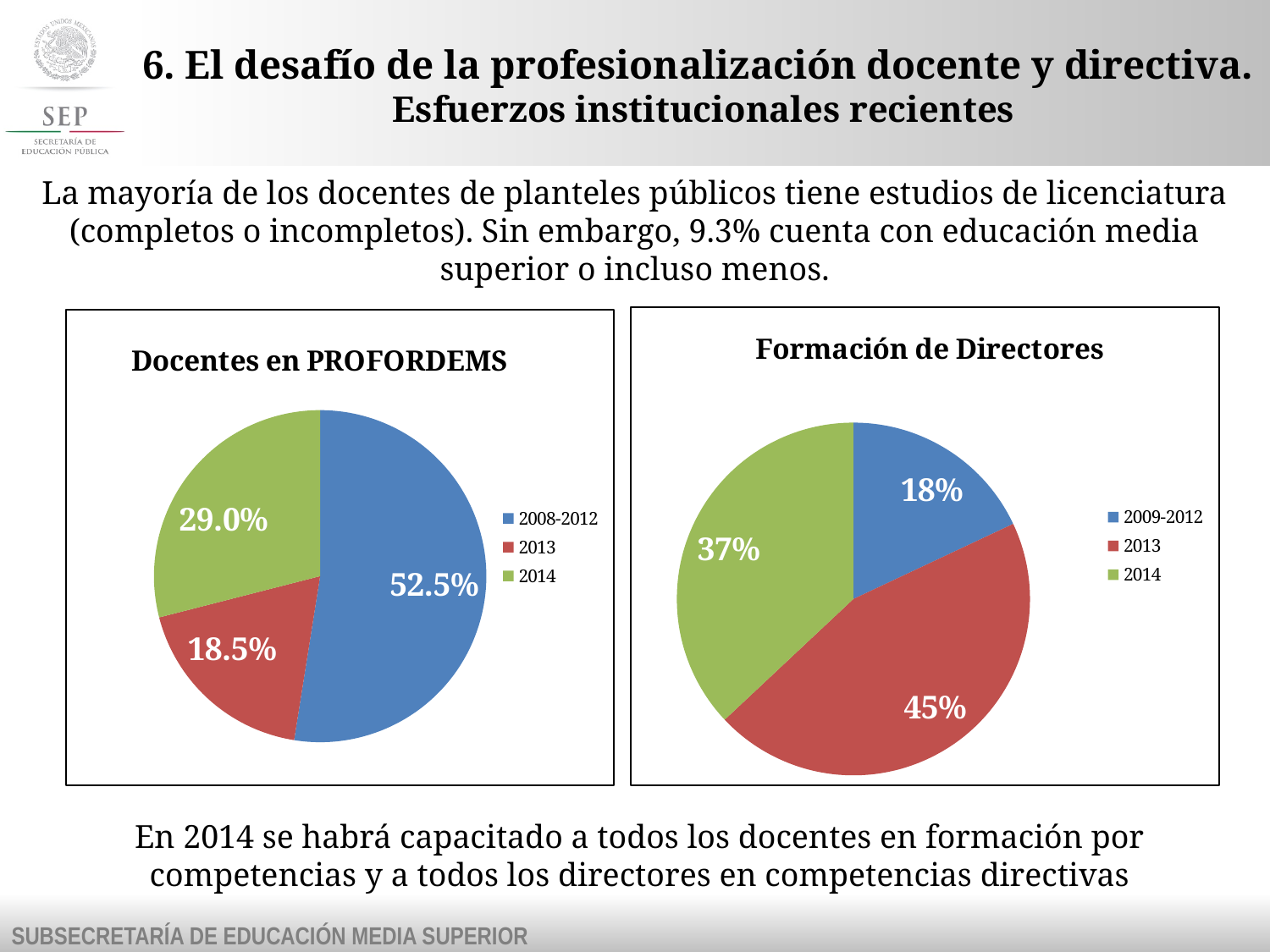
In the 'Docentes en PROFORDEMS' chart, how many slices does the pie have? 3 In the 'Docentes en PROFORDEMS' chart, what is the difference between the 2014 and 2013 slices? 10.5% In the 'Docentes en PROFORDEMS' chart, what is the value for 2008-2012? 52.5% In the 'Docentes en PROFORDEMS' chart, which category has the smallest slice? 2013 What type of chart is the 'Formación de Directores' chart? Pie chart In the 'Formación de Directores' chart, which category has the largest slice? 2013 In the 'Formación de Directores' chart, what is the value for 2013? 45% In the 'Docentes en PROFORDEMS' chart, what colour is the 2014 slice? Green In the 'Formación de Directores' chart, which is larger, the 2014 slice or the 2009-2012 slice? 2014 In the 'Docentes en PROFORDEMS' chart, what is the value for 2013? 18.5% In the 'Formación de Directores' chart, what is the difference between the 2013 and 2014 slices? 8% In the 'Formación de Directores' chart, what is the value for 2009-2012? 18%